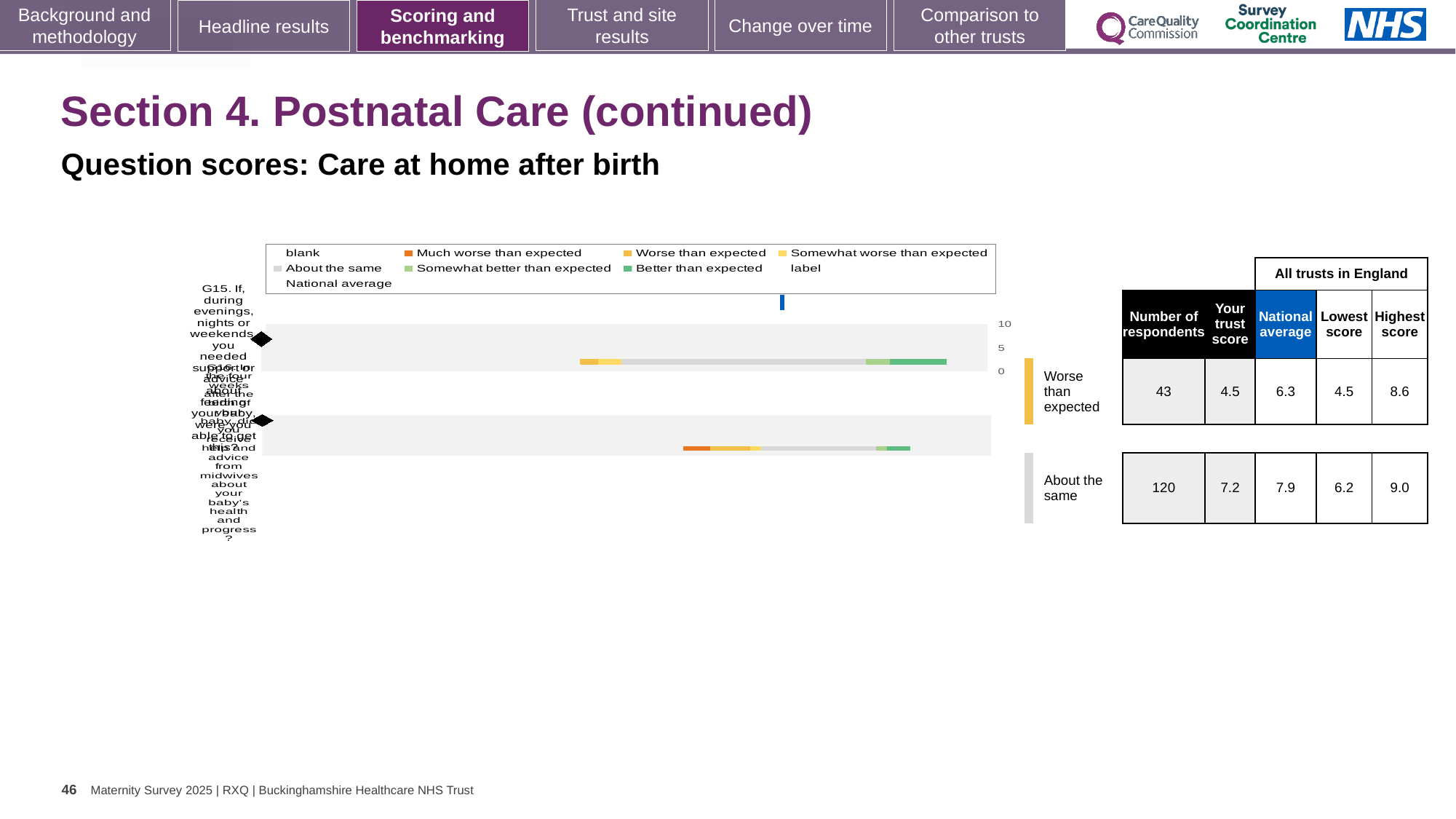
In the table, what is the highest score across all trusts in England for the question rated 'About the same'? 9.0 In the table, what is the lowest score across all trusts in England for the question rated 'Worse than expected'? 4.5 For the question rated 'About the same', what is the difference between the highest and lowest scores across all trusts in England? 2.8 For the question rated 'Worse than expected', how much higher is the national average than the trust score? 1.8 In the table, how many respondents are shown for the question rated 'Worse than expected'? 43 How many more respondents does the 'About the same' row have than the 'Worse than expected' row? 77 What kind of chart is shown on the slide? Bar chart Which row in the table has more respondents, 'Worse than expected' or 'About the same'? About the same What is the subtitle describing the question scores on this slide? Question scores: Care at home after birth In the table, what is the national average for the question rated 'Worse than expected'? 6.3 In the table, what is the 'Your trust score' for the question rated 'About the same'? 7.2 For the question rated 'About the same', which is larger: the trust score or the national average? National average